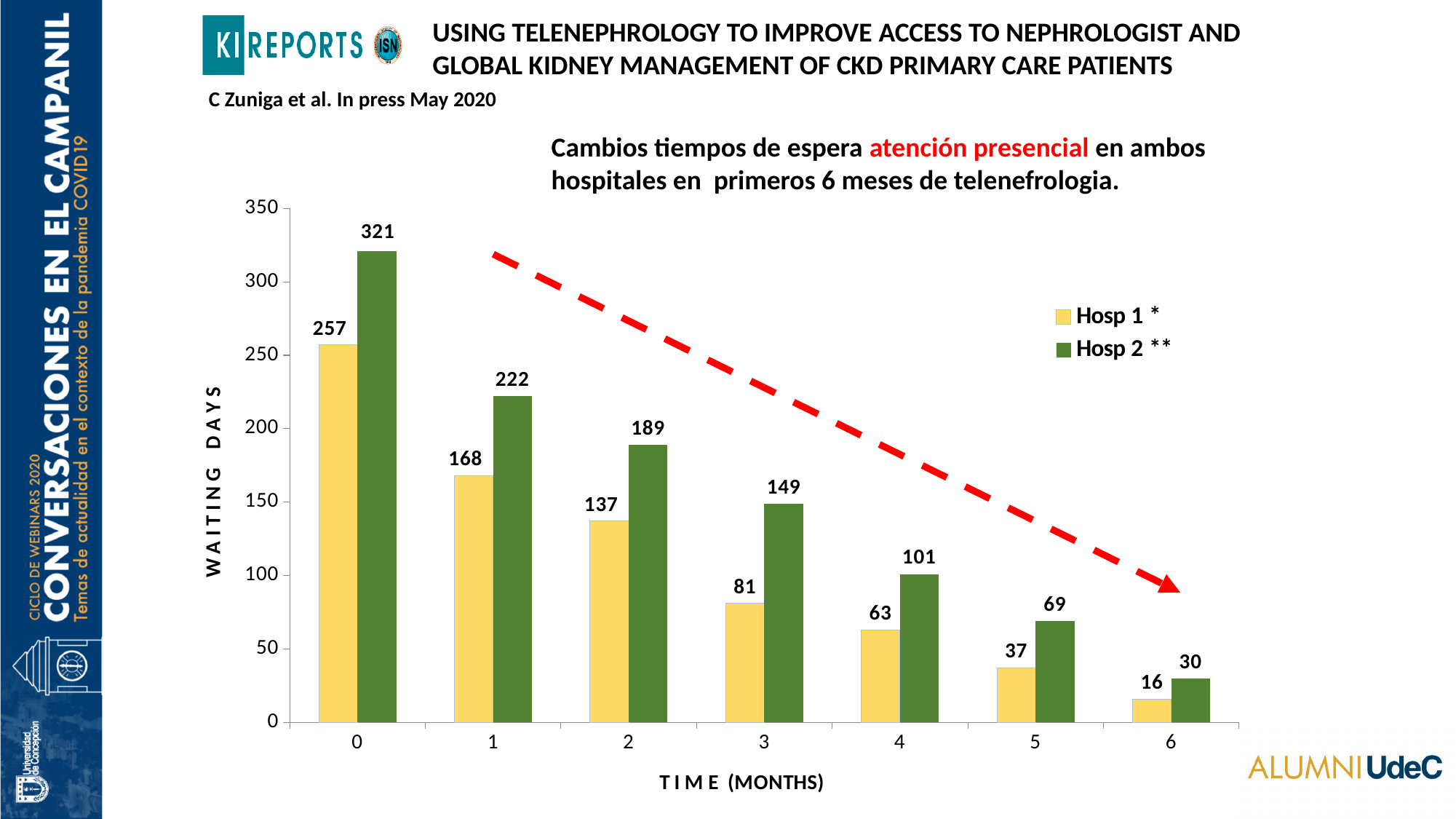
What is the waiting days value for Hosp 2 at month 0? 321 How many time points (months) are shown on the x axis? 7 At which month is the Hosp 2 waiting days value highest? 0 How many series does the legend list? 2 What is the difference in waiting days between Hosp 2 and Hosp 1 at month 1? 54 Do the waiting days for Hosp 2 rise or fall from month 0 to month 6? Fall What is the label of the y axis? WAITING DAYS At which month is the Hosp 1 waiting days value lowest? 6 What is the waiting days value for Hosp 1 at month 3? 81 Which has more waiting days at month 4, Hosp 1 or Hosp 2? Hosp 2 What kind of chart is shown on the slide? Bar chart What is the waiting days value for Hosp 1 at month 6? 16